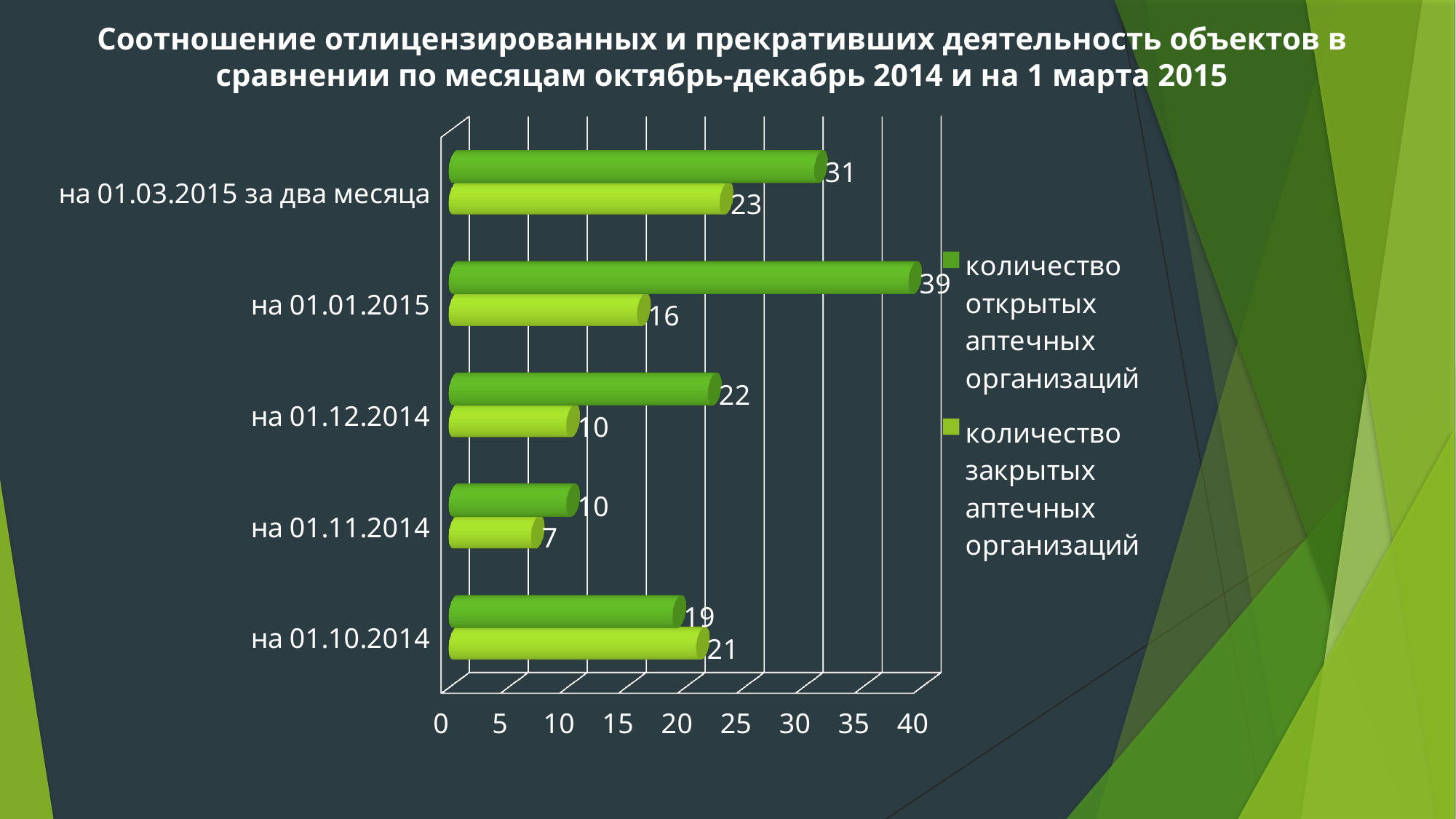
At 'на 01.10.2014', which is larger: 'количество открытых аптечных организаций' or 'количество закрытых аптечных организаций'? количество закрытых аптечных организаций How many series does the legend list? 2 What is the value for 'количество закрытых аптечных организаций' at 'на 01.03.2015 за два месяца'? 23 What is the difference between 'количество открытых аптечных организаций' at 'на 01.03.2015 за два месяца' and at 'на 01.11.2014'? 21 What kind of chart is shown on the slide? bar chart What is the value for 'количество закрытых аптечных организаций' at 'на 01.10.2014'? 21 Which category has the highest value for 'количество открытых аптечных организаций'? на 01.01.2015 What is the difference between 'количество открытых аптечных организаций' and 'количество закрытых аптечных организаций' at 'на 01.01.2015'? 23 Which category has the lowest value for 'количество закрытых аптечных организаций'? на 01.11.2014 What is the value for 'количество открытых аптечных организаций' at 'на 01.01.2015'? 39 What is the value for 'количество открытых аптечных организаций' at 'на 01.12.2014'? 22 How many categories are shown on the chart? 5